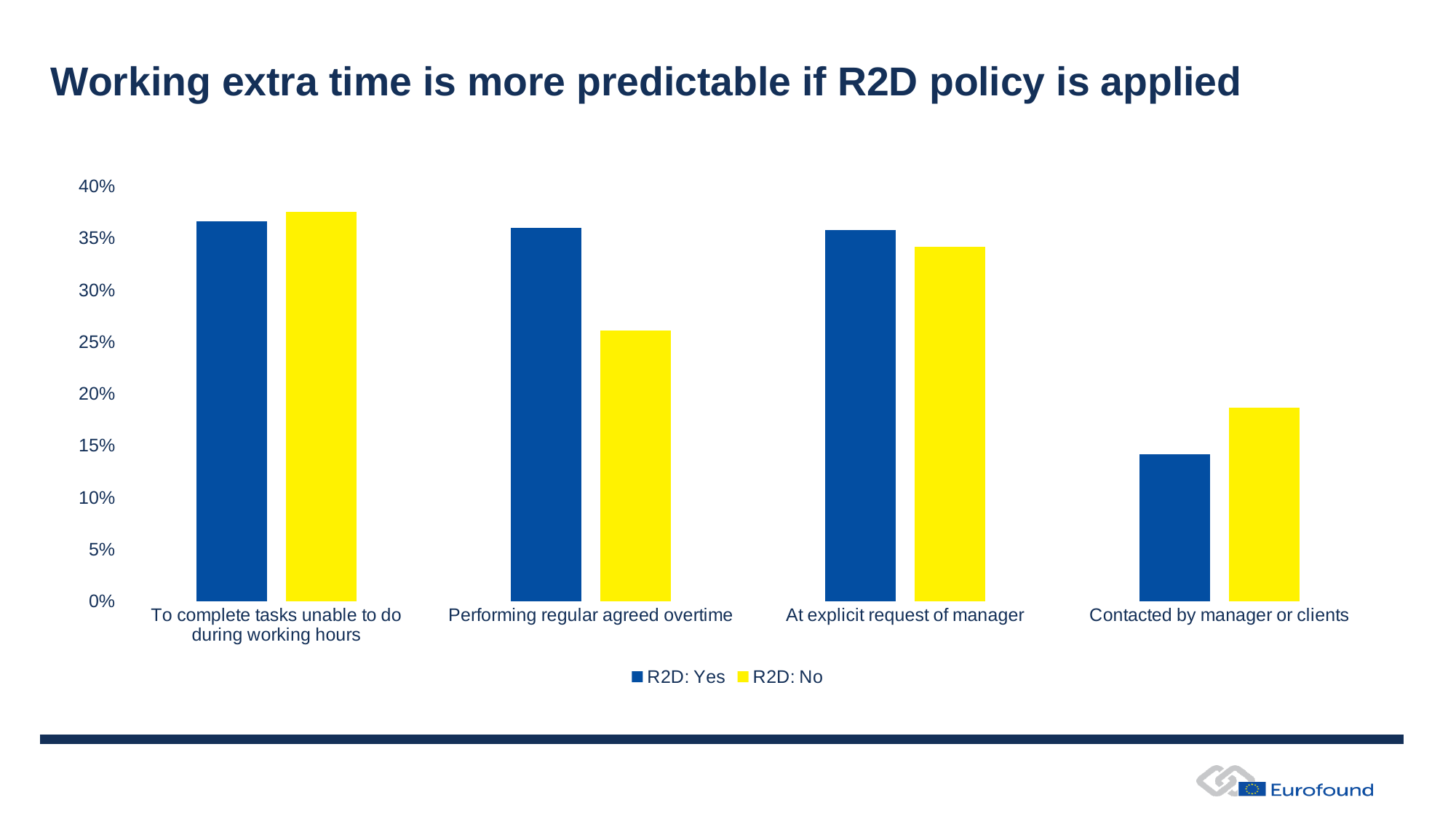
What kind of chart is shown on the slide? bar chart For 'Performing regular agreed overtime', which series has the larger value, R2D: Yes or R2D: No? R2D: Yes For 'Contacted by manager or clients', which series has the larger value, R2D: Yes or R2D: No? R2D: No What is the title of the slide containing the chart? Working extra time is more predictable if R2D policy is applied How many categories are shown on the x axis of the chart? 4 How many series does the legend list? 2 Is the R2D: No value for 'Performing regular agreed overtime' greater or less than 30%? less What are the two series named in the legend? R2D: Yes and R2D: No Which category has the highest value for the R2D: No series? To complete tasks unable to do during working hours Is the R2D: Yes value for 'At explicit request of manager' greater or less than 30%? greater Which category has the lowest value for the R2D: Yes series? Contacted by manager or clients